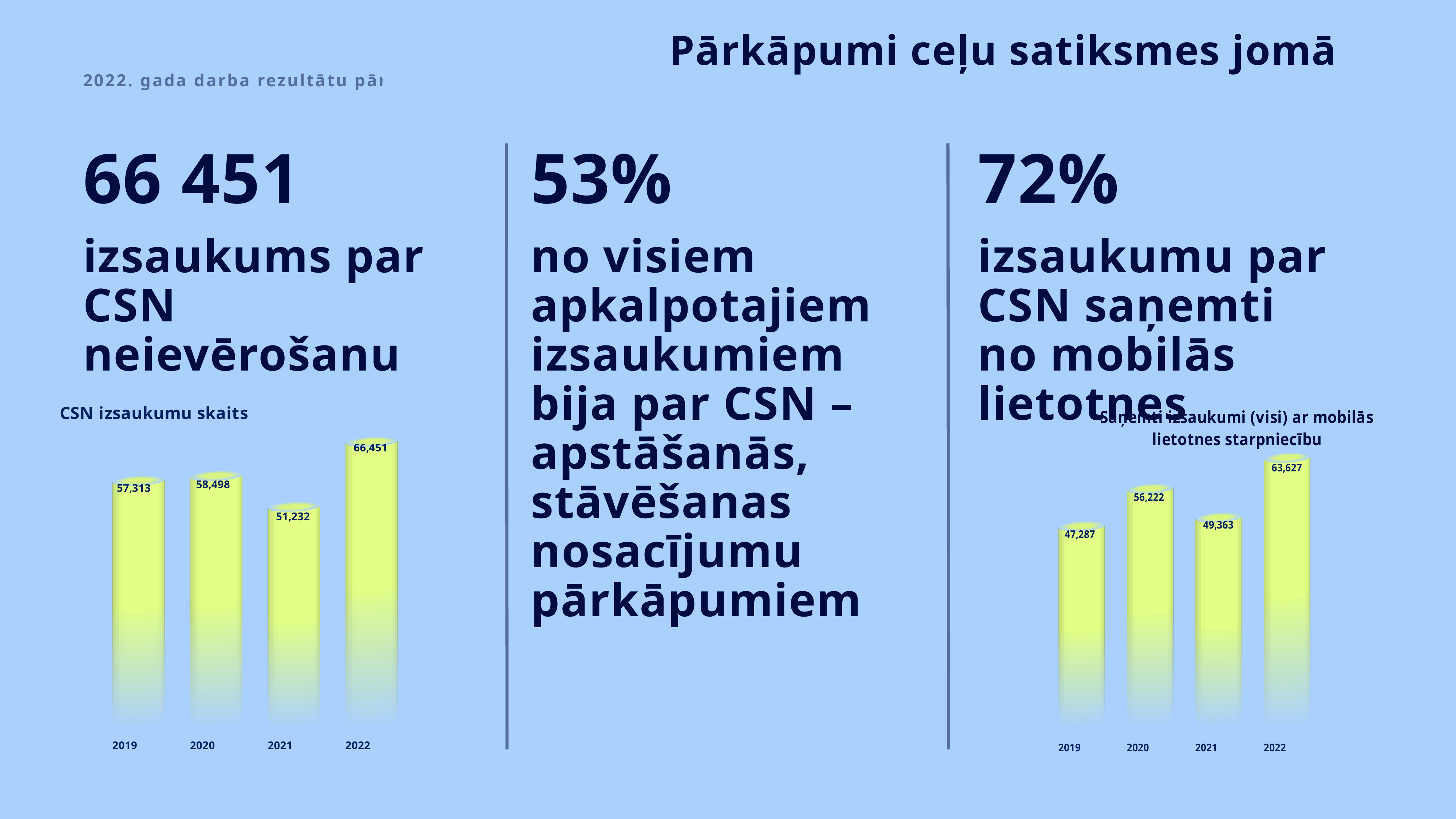
In the chart titled "CSN izsaukumu skaits", which year has the lowest value? 2021 In the chart titled "CSN izsaukumu skaits", what is the value for 2022? 66,451 What kind of chart is the chart titled "CSN izsaukumu skaits"? Bar chart In the chart on the right ("Saņemti izsaukumi (visi) ar mobilās lietotnes starpniecību"), what is the value for 2020? 56,222 In the chart titled "CSN izsaukumu skaits", how many years are shown? 4 In the chart on the right ("Saņemti izsaukumi (visi) ar mobilās lietotnes starpniecību"), which is larger, the value for 2020 or the value for 2021? 2020 In the chart titled "CSN izsaukumu skaits", which year has the highest value? 2022 In the chart on the right ("Saņemti izsaukumi (visi) ar mobilās lietotnes starpniecību"), what is the difference between the 2022 and 2019 values? 16,340 In the chart titled "CSN izsaukumu skaits", what is the difference between the 2022 and 2021 values? 15,219 In the chart titled "CSN izsaukumu skaits", what is the value for 2021? 51,232 In the chart on the right ("Saņemti izsaukumi (visi) ar mobilās lietotnes starpniecību"), what is the value for 2019? 47,287 In the chart on the right ("Saņemti izsaukumi (visi) ar mobilās lietotnes starpniecību"), which year has the lowest value? 2019